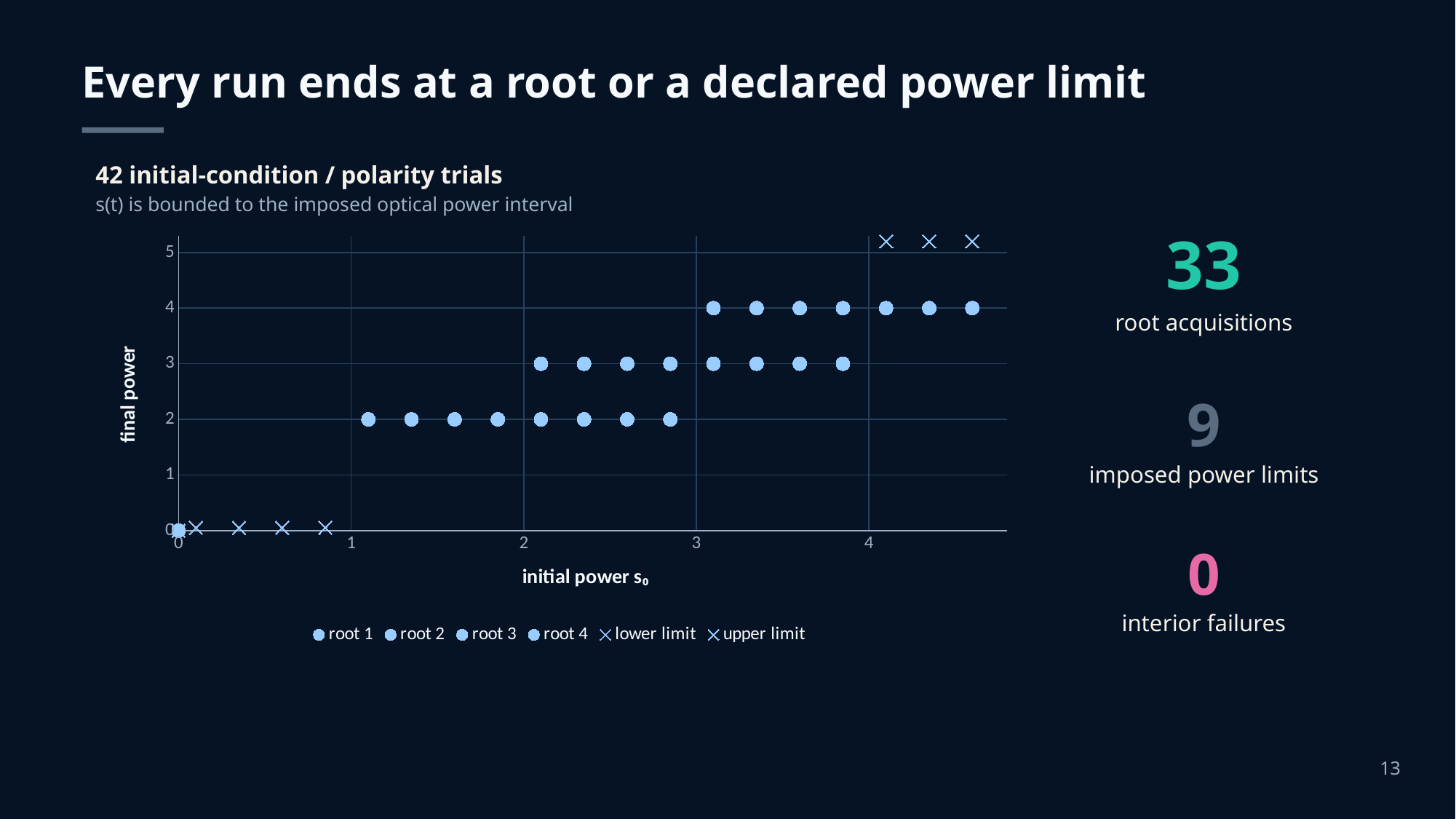
What is the title of the chart's horizontal axis? initial power s₀ How many series does the chart legend list? 6 What is the title of the chart's vertical axis? final power What is the highest final power reached by the circular root markers? 4 What kind of chart is shown on the slide? scatter chart Is the final power of the lower limit points greater or less than 1? less Is the final power of the upper limit points greater or less than 5? greater As initial power increases along the x axis, does the final power of the root points rise or fall? rise